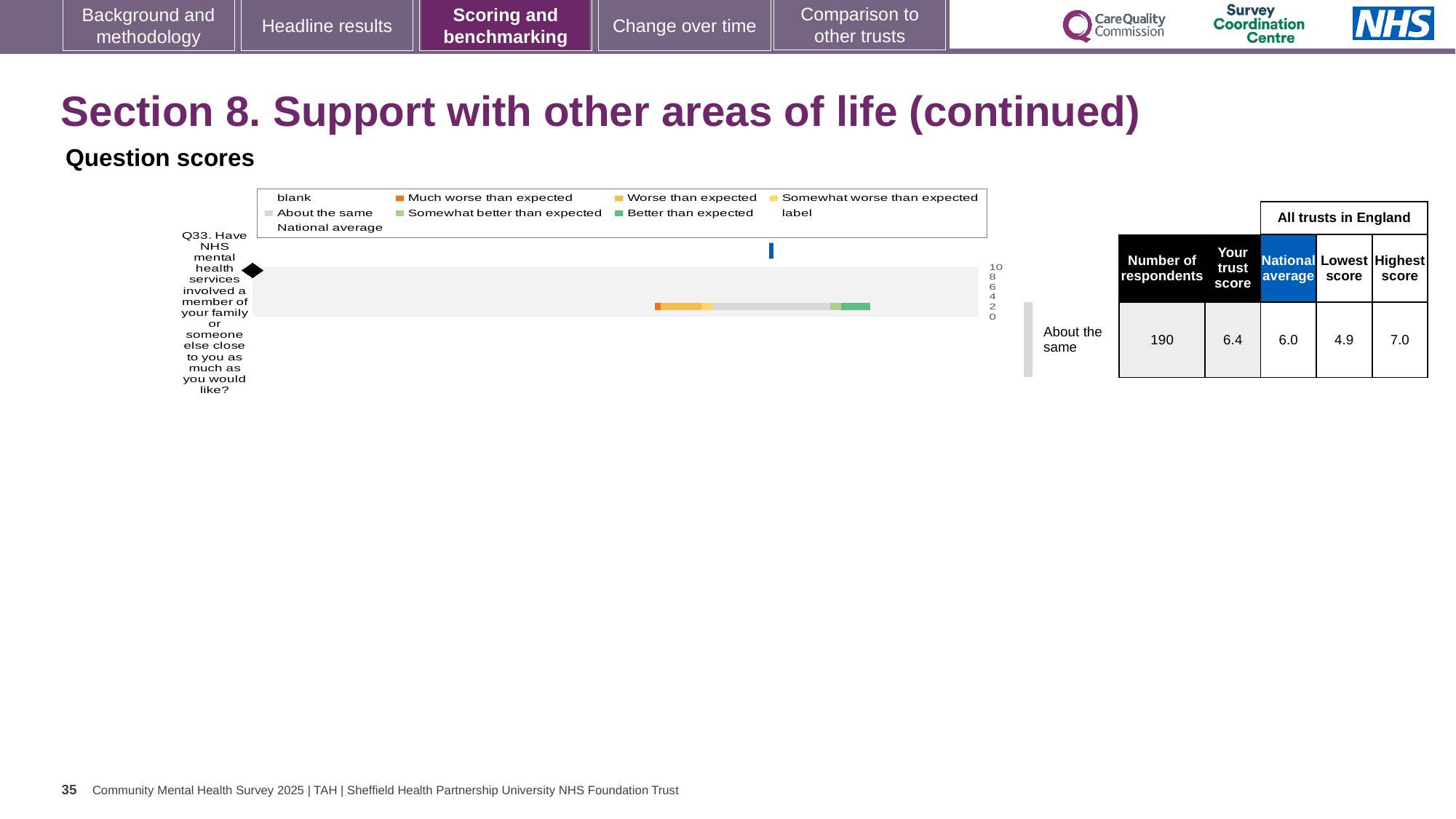
What kind of chart is shown on the slide? bar chart Which question is plotted in the chart? Q33. Have NHS mental health services involved a member of your family or someone else close to you as much as you would like? In the table beside the chart, what is the number of respondents for Q33? 190 In the table beside the chart, what is the national average for Q33? 6.0 What colour does the legend use for 'Much worse than expected'? orange In the table beside the chart, what is 'Your trust score' for Q33? 6.4 In the table beside the chart, what is the lowest score among all trusts in England for Q33? 4.9 What benchmark category label is shown next to the bar for Q33? About the same How many questions (categories) are plotted in the chart? 1 In the table beside the chart, what is the highest score among all trusts in England for Q33? 7.0 How many entries does the chart legend list? 9 Which is larger for Q33: your trust score or the national average? your trust score